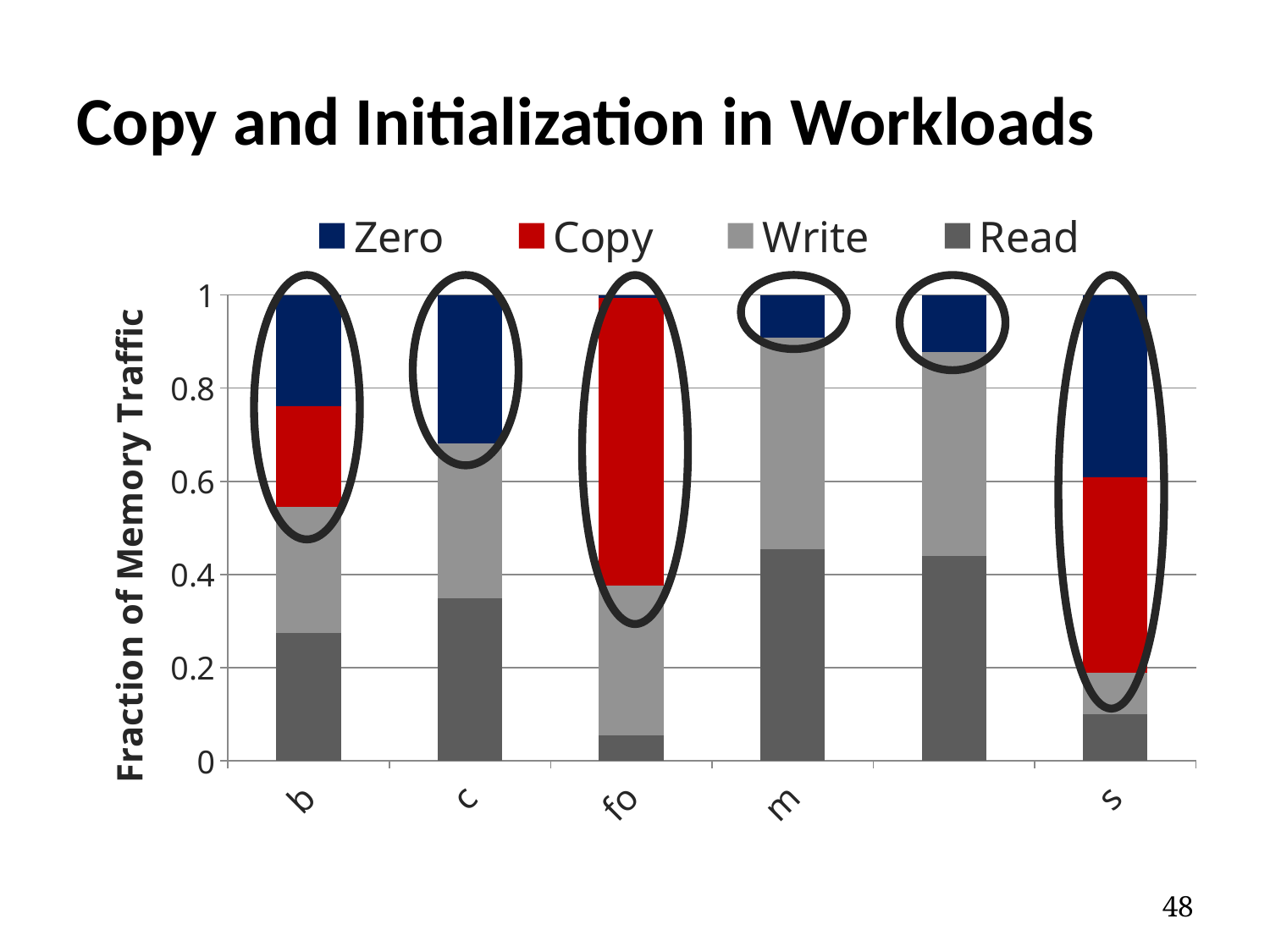
Is the Read value for workload fo greater or less than 0.2? less Which workload has the largest Copy segment? fo Is the Read value for workload s greater or less than 0.2? less What is the total height of the stacked bar for workload b? 1 Is the Read value for workload m greater or less than 0.4? greater How many series does the legend list? 4 What is the label of the vertical axis? Fraction of Memory Traffic How many bars are plotted in the chart? 6 What is the title of the chart on the slide? Copy and Initialization in Workloads What kind of chart is shown on the slide? stacked bar chart Which workload has the largest Zero segment? s Is the Copy segment larger for workload fo or for workload b? fo